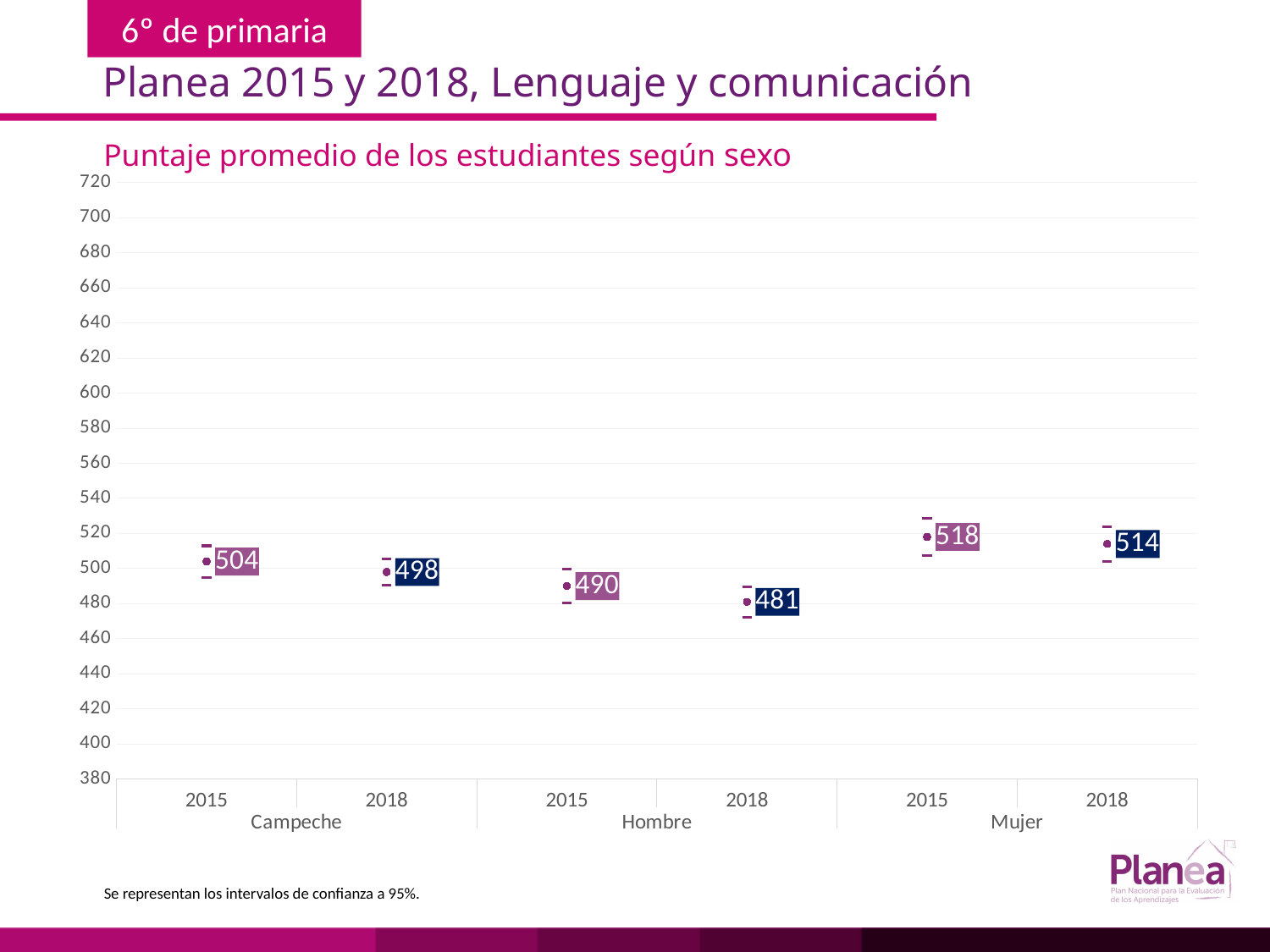
What is the average score for Mujer in 2015? 518 What is the difference between the Mujer 2015 score and the Hombre 2015 score? 28 What is the title of the chart? Puntaje promedio de los estudiantes según sexo What is the average score for Campeche in 2015? 504 Which group and year has the highest average score? Mujer 2015 Is the value for Hombre 2018 greater or less than 500? less By how much did the Campeche average score change from 2015 to 2018? 6 What is the average score for Hombre in 2018? 481 Which group and year has the lowest average score? Hombre 2018 How many data points are plotted on the chart? 6 What is the average score for Campeche in 2018? 498 Which is larger, the Mujer 2018 score or the Campeche 2015 score? Mujer 2018